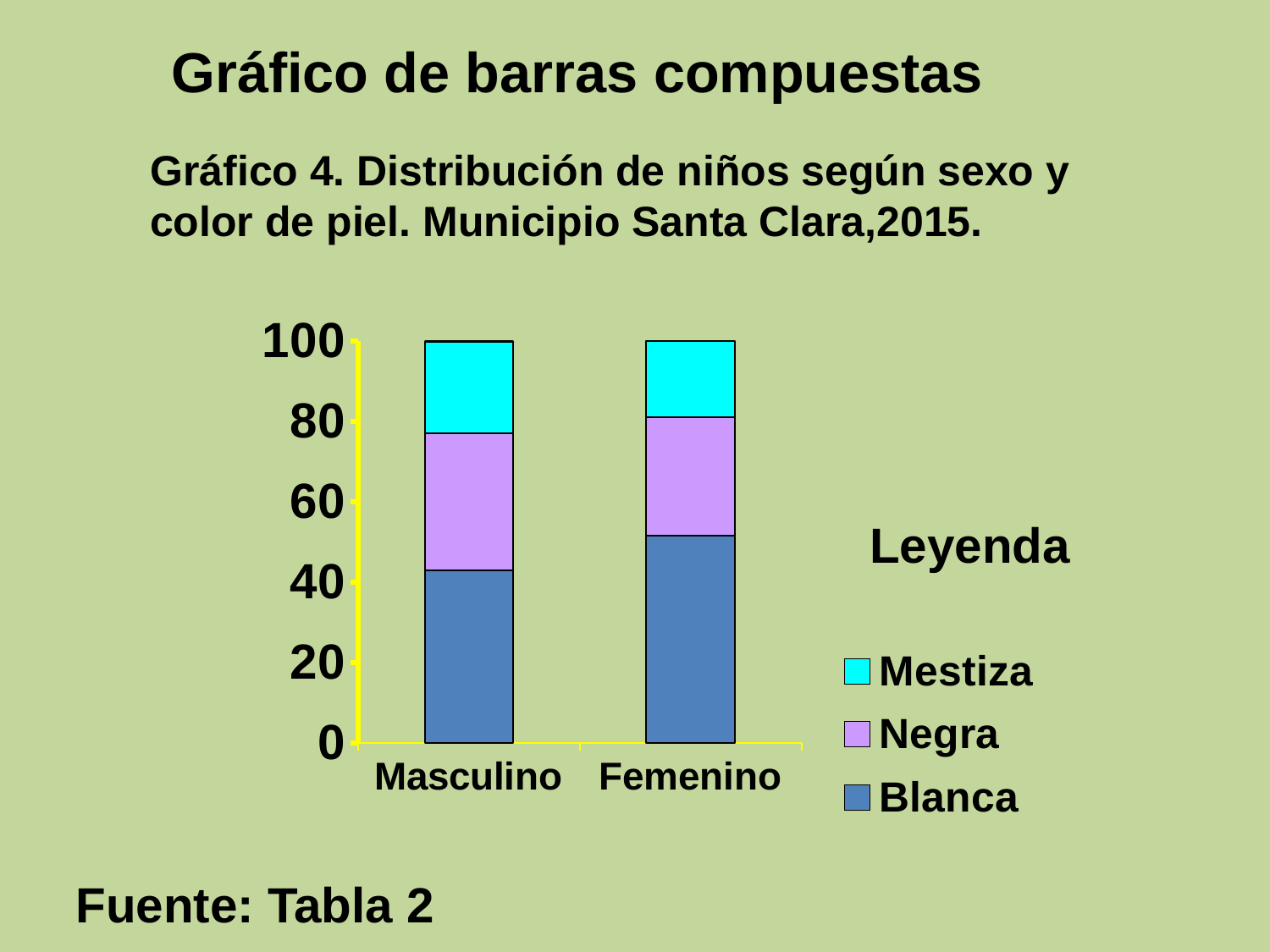
Is the Blanca value for Femenino greater or less than 40? greater What is the total height of the Femenino stacked bar? 100 Which category has the larger Blanca segment, Masculino or Femenino? Femenino Is the Blanca value for Masculino greater or less than 40? greater What is the title of the chart (Gráfico 4)? Distribución de niños según sexo y color de piel. Municipio Santa Clara, 2015. What is the total height of the Masculino stacked bar? 100 How many categories are shown on the x axis of the chart? 2 What kind of chart is shown on the slide? Stacked bar chart Which category has the larger Mestiza segment, Masculino or Femenino? Masculino Which series is shown at the bottom of each stacked bar? Blanca How many series does the legend list? 3 Is the Blanca value for Femenino greater or less than 60? less